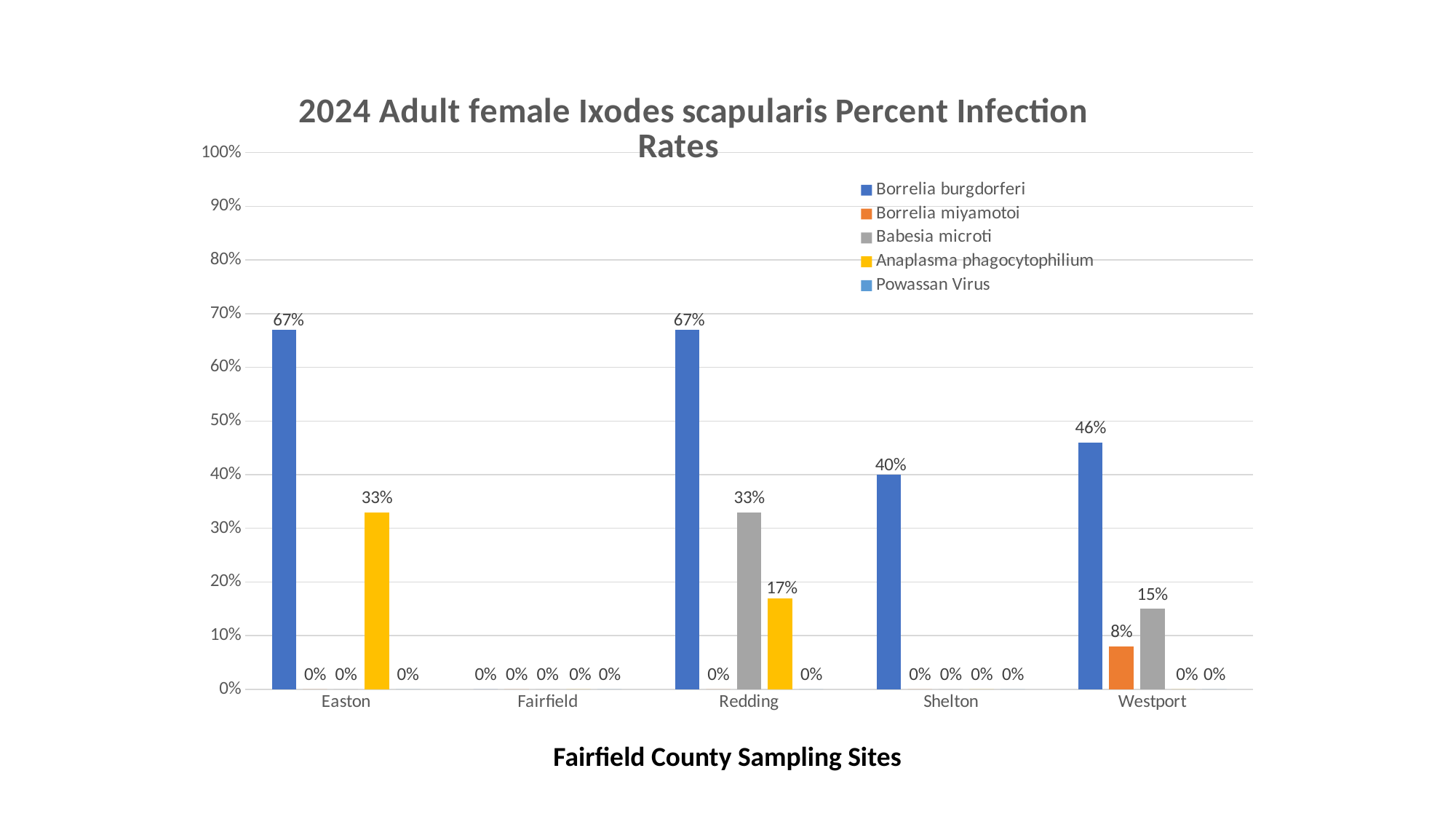
Which is larger: the Babesia microti rate at Redding or at Westport? Redding How many series does the legend list? 5 Which sampling site has the lowest Borrelia burgdorferi infection rate? Fairfield How many sampling sites are shown on the x axis? 5 What kind of chart is shown on the slide? Bar chart What is the Borrelia burgdorferi infection rate at Shelton? 40% What is the x-axis title of the chart? Fairfield County Sampling Sites What is the Borrelia miyamotoi infection rate at Westport? 8% What is the Babesia microti infection rate at Westport? 15% What is the Anaplasma phagocytophilium infection rate at Redding? 17% What is the Borrelia burgdorferi infection rate at Easton? 67% What is the difference between the Borrelia burgdorferi rate at Westport and at Shelton? 6%